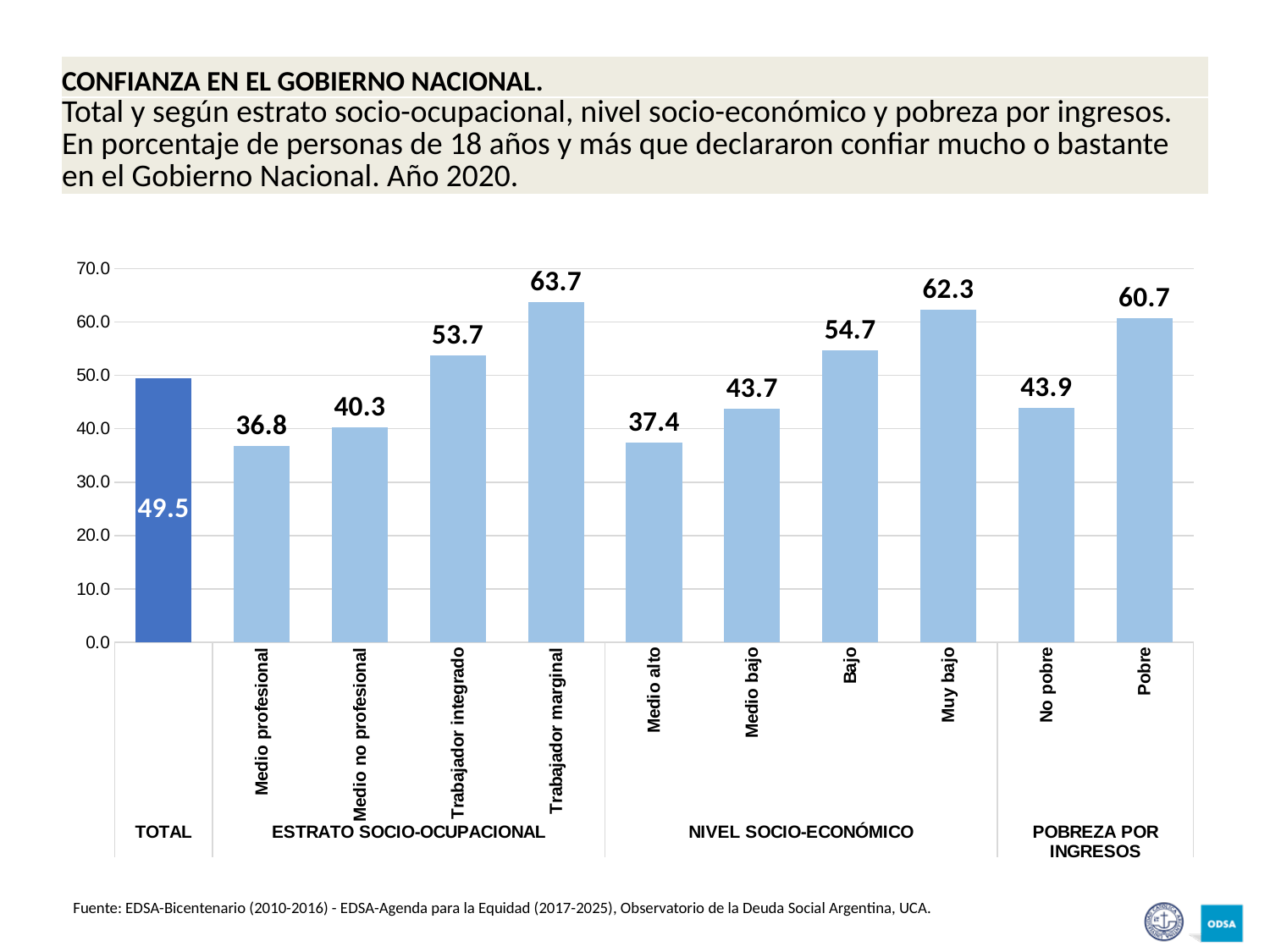
What is the value for TOTAL? 49.5 Which is larger, the value for Muy bajo or the value for Bajo? Muy bajo Is the value for Trabajador integrado greater or less than 50.0? greater What is the value for Pobre? 60.7 Which category has the lowest value? Medio profesional Which category has the highest value? Trabajador marginal What is the value for Medio bajo? 43.7 What kind of chart is shown on the slide? bar chart Do the values rise or fall across the four ESTRATO SOCIO-OCUPACIONAL categories from left to right? rise How many bars are plotted in the chart? 11 What is the value for Trabajador marginal? 63.7 What is the difference between the values for Pobre and No pobre? 16.8